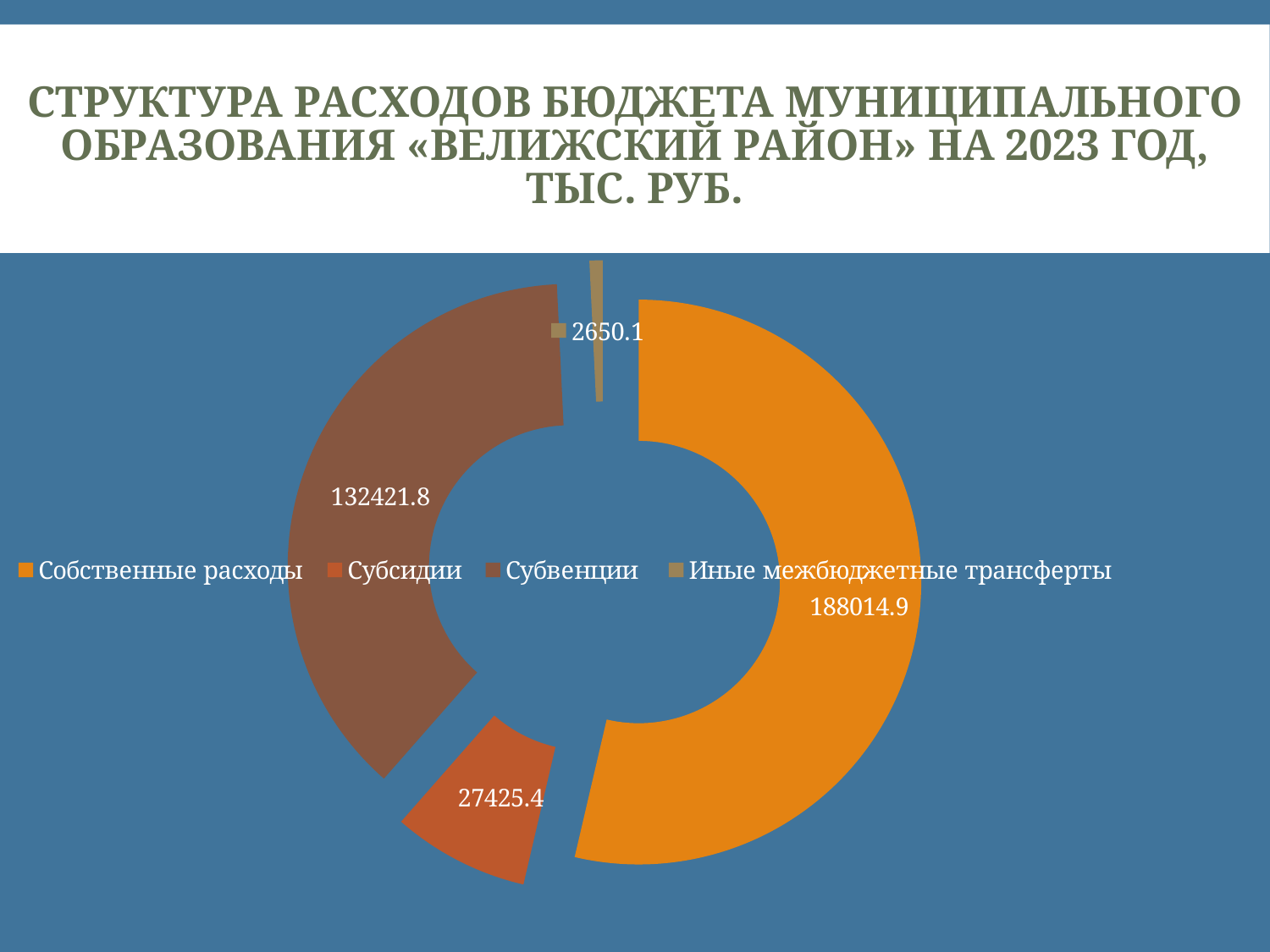
What is the value for Собственные расходы? 188014.9 What is the difference between Собственные расходы and Субвенции? 55593.1 How many categories does the chart show? 4 What is the value for Иные межбюджетные трансферты? 2650.1 Which category has the largest value? Собственные расходы Which category has the smallest value? Иные межбюджетные трансферты What kind of chart is shown on the slide? doughnut chart What colour is the Собственные расходы segment? orange What is the value for Субвенции? 132421.8 What is the difference between Субсидии and Иные межбюджетные трансферты? 24775.3 Which is larger, Субвенции or Субсидии? Субвенции What is the value for Субсидии? 27425.4